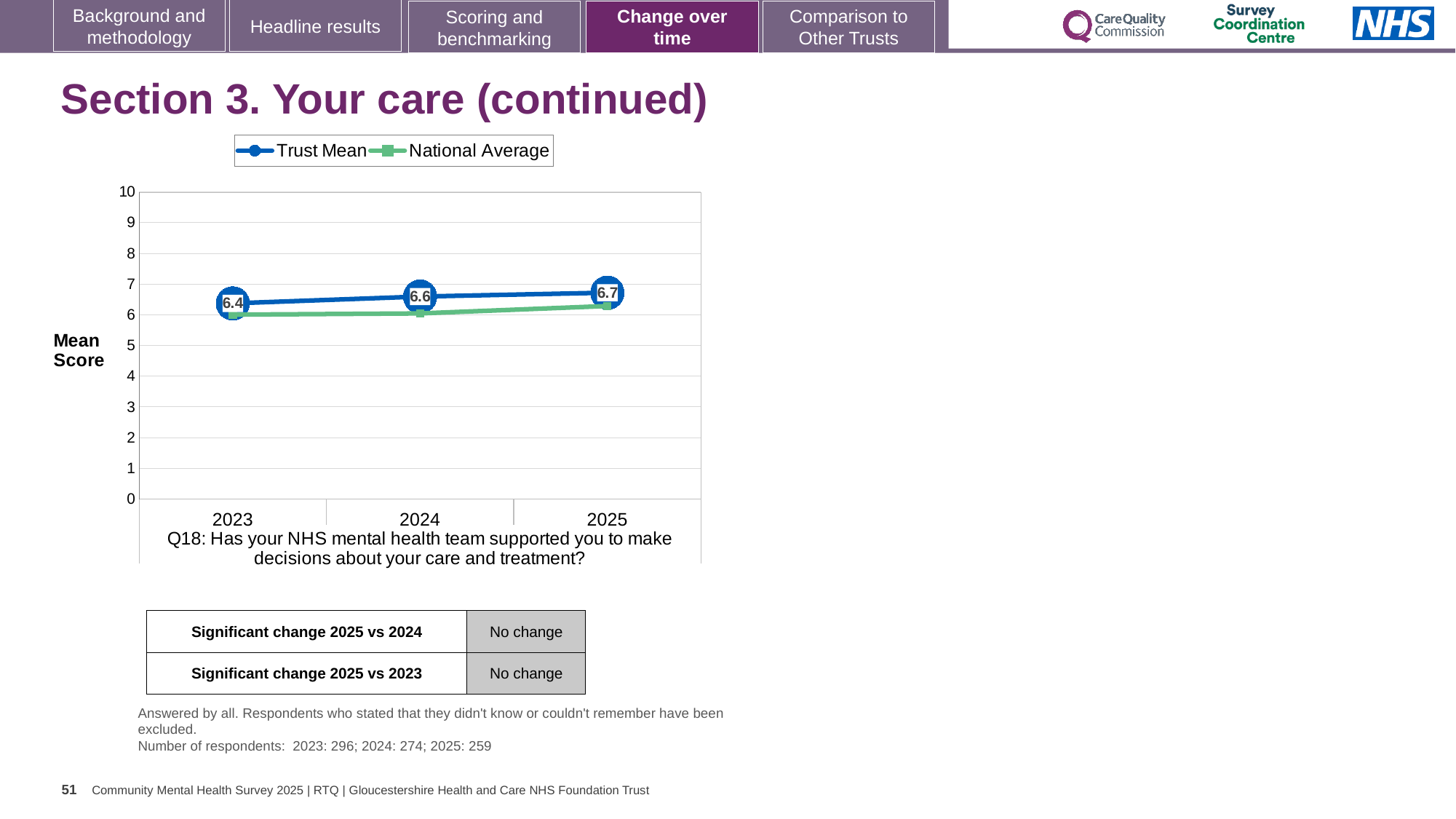
What is the Trust Mean value for 2025? 6.7 In which year is the Trust Mean lowest? 2023 Does the Trust Mean rise or fall from 2023 to 2025? Rise In which year is the Trust Mean highest? 2025 What is the difference between the Trust Mean in 2025 and in 2023? 0.3 What is the Trust Mean value for 2023? 6.4 What kind of chart is shown on the slide? Line chart In 2023, which is larger: the Trust Mean or the National Average? Trust Mean How many series does the legend list? 2 How many years are plotted on the x axis? 3 Is the National Average value for 2023 greater or less than 5? greater What is the Trust Mean value for 2024? 6.6